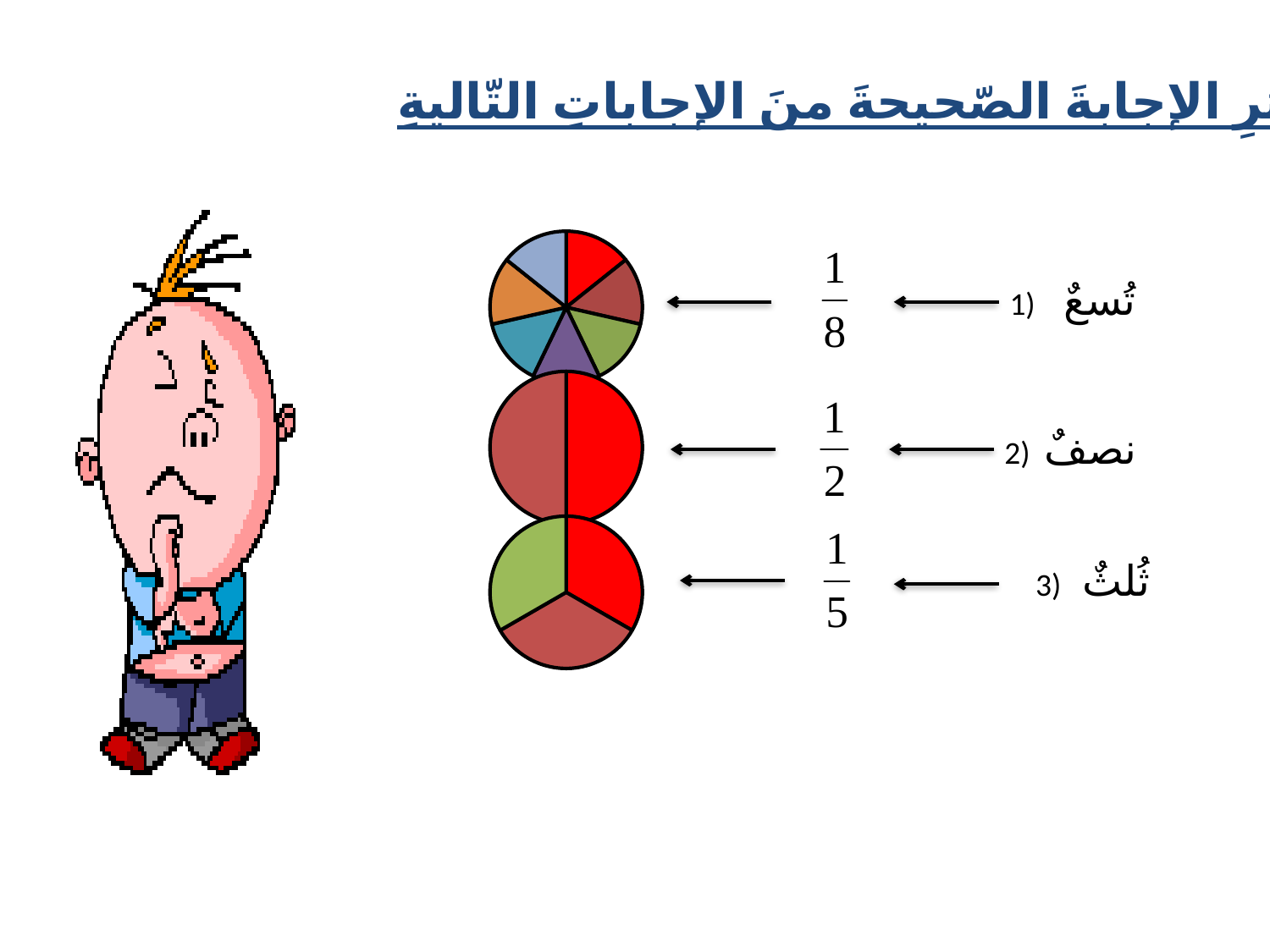
In the top pie chart, what fraction of the whole does one slice represent? 1/7 In the middle pie chart, are the red slice and the brown slice the same size? yes How many pie charts are shown on the slide? 3 What kind of chart is the top chart on the slide? pie chart How many slices does the bottom pie chart have? 3 What colour is the right half of the middle pie chart? red How many slices does the middle pie chart have? 2 What fraction is written next to the bottom pie chart? 1/5 In the middle pie chart, what fraction of the whole does the red slice represent? 1/2